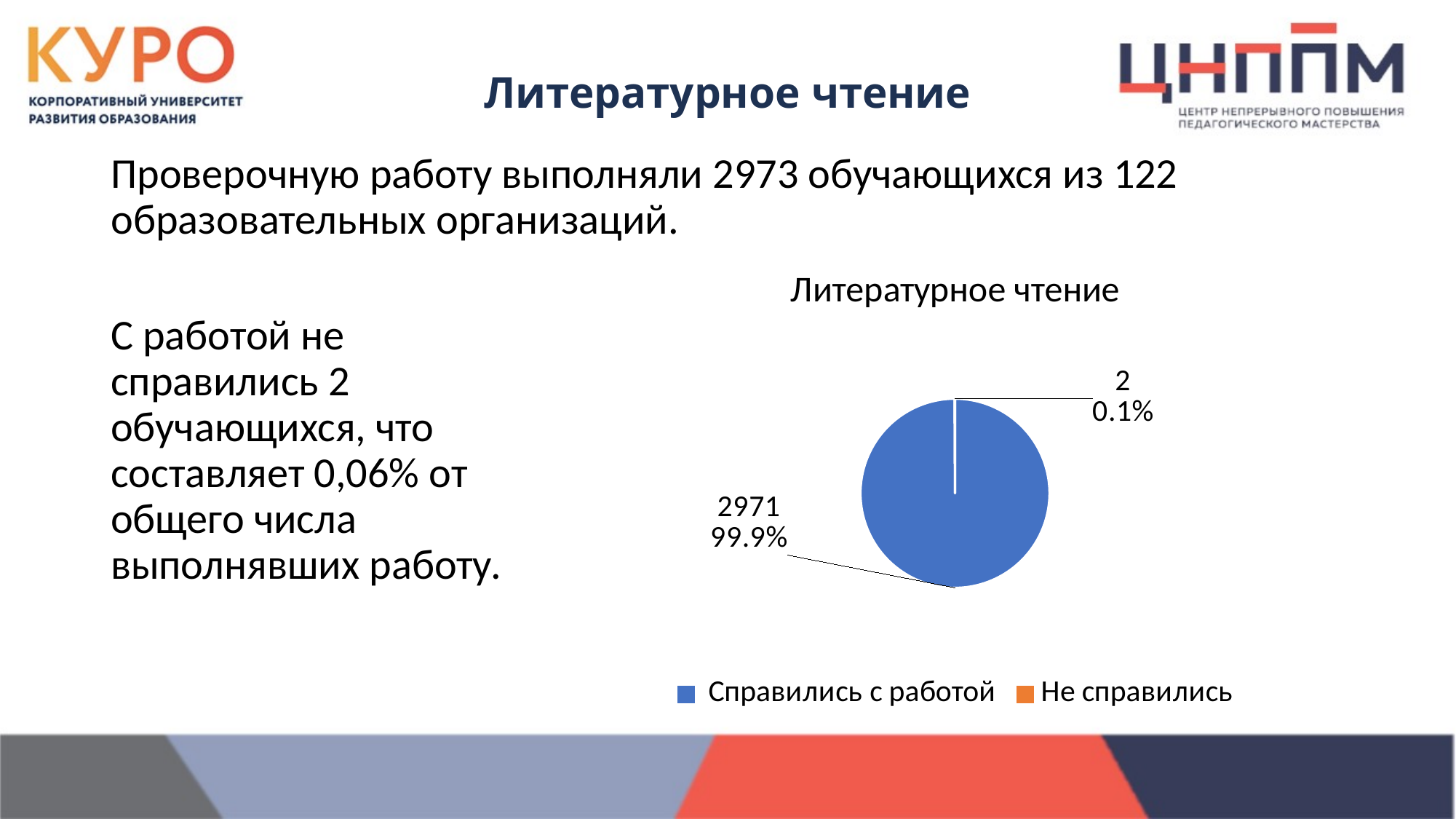
What is the difference between the values for "Справились с работой" and "Не справились"? 2969 Which colour represents "Не справились" in the legend? Orange How many entries does the chart legend list? 2 What is the title of the chart? Литературное чтение What type of chart is shown on the slide? Pie chart How many slices does the pie chart have? 2 Which category has the smallest slice? Не справились What share of the pie does "Не справились" represent? 0.1% What share of the pie does "Справились с работой" represent? 99.9% What is the value for "Не справились"? 2 Which category has the largest slice? Справились с работой What is the value for "Справились с работой"? 2971